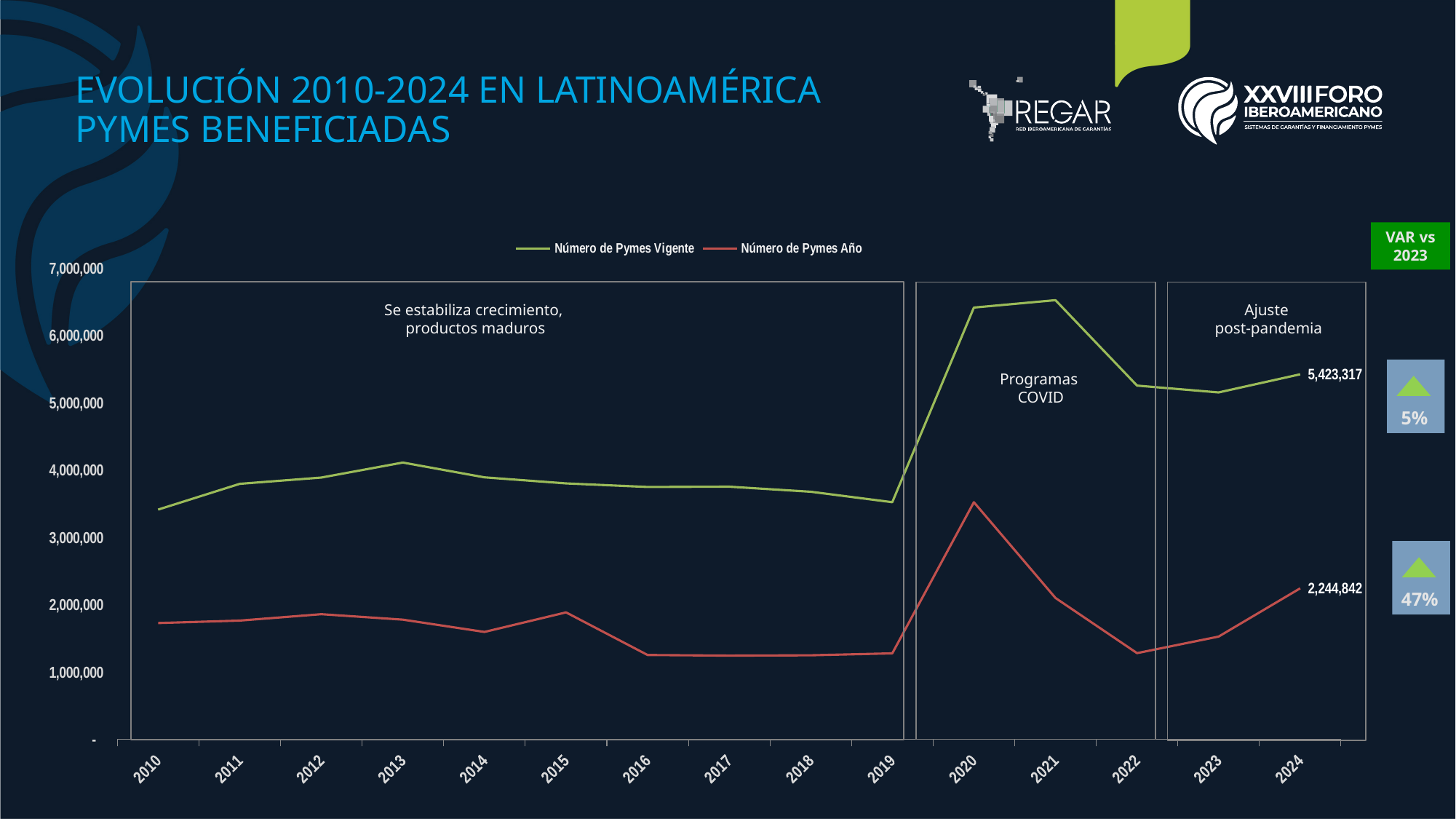
In which year is Número de Pymes Año highest? 2020 How many series does the legend list? 2 How many years are plotted along the x axis? 15 Is the value for Número de Pymes Vigente in 2020 greater or less than 6,000,000? greater What is the value of Número de Pymes Vigente in 2024? 5,423,317 Does Número de Pymes Año rise or fall from 2022 to 2024? rise What kind of chart is shown on the slide? line chart Is the value for Número de Pymes Año in 2020 greater or less than 3,000,000? greater What is the difference between Número de Pymes Vigente and Número de Pymes Año in 2024? 3,178,475 What percentage variation vs 2023 is shown next to the Número de Pymes Año line? 47% What is the value of Número de Pymes Año in 2024? 2,244,842 Which series has the larger value in 2024, Número de Pymes Vigente or Número de Pymes Año? Número de Pymes Vigente